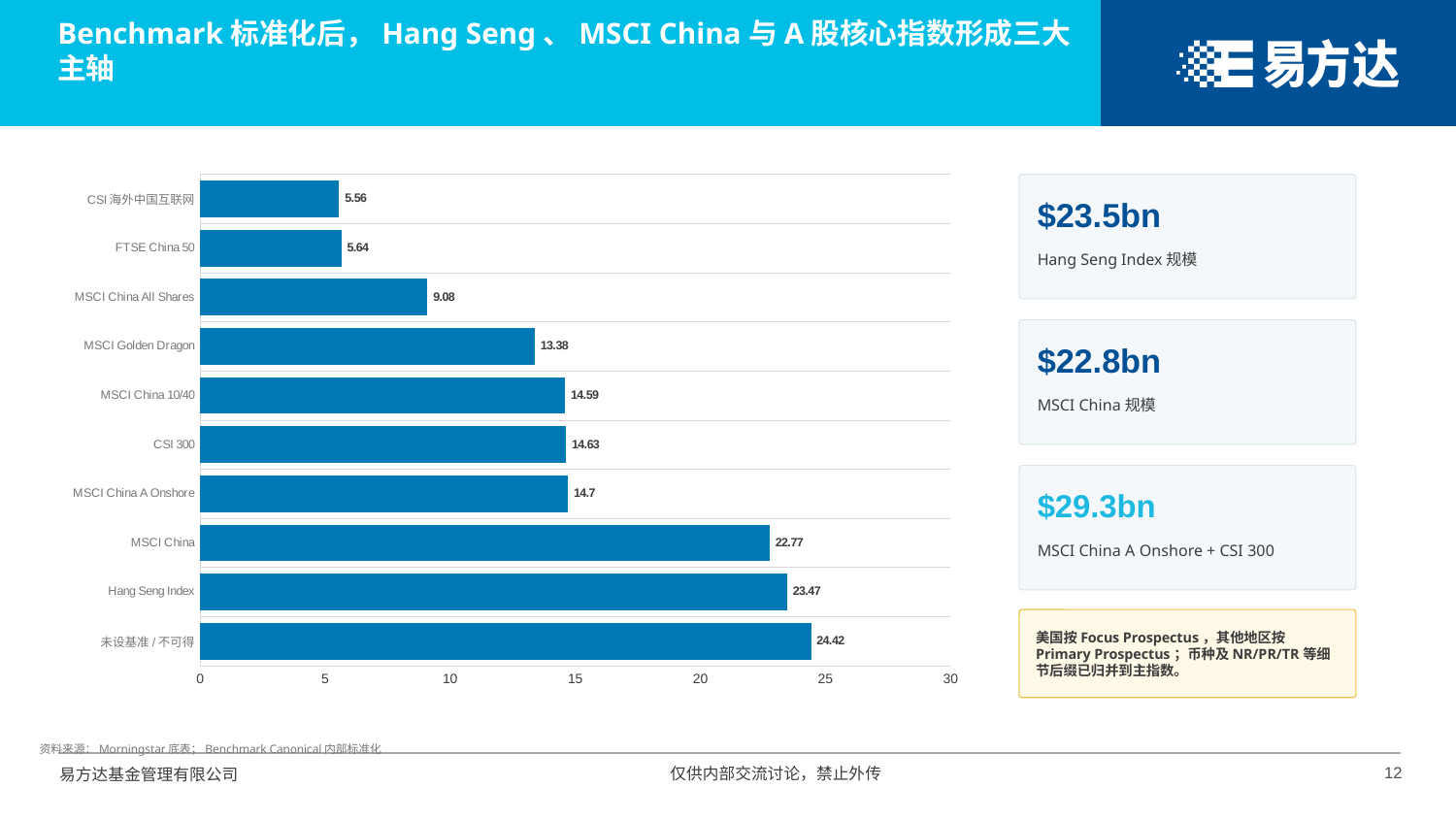
Which category has the highest value in the bar chart? 未设基准 / 不可得 What is the maximum value shown on the horizontal axis of the bar chart? 30 What is the value for MSCI Golden Dragon? 13.38 Is the value for MSCI Golden Dragon greater or less than 15? less What is the difference between the values for MSCI China and MSCI China All Shares? 13.69 Which category has the lowest value in the bar chart? CSI 海外中国互联网 What kind of chart is shown on the slide? bar chart What is the difference between the values for Hang Seng Index and MSCI China? 0.70 How many categories are plotted in the bar chart? 10 What is the value for Hang Seng Index in the bar chart? 23.47 What is the value for MSCI China All Shares? 9.08 Which is larger, the value for CSI 300 or the value for MSCI China 10/40? CSI 300